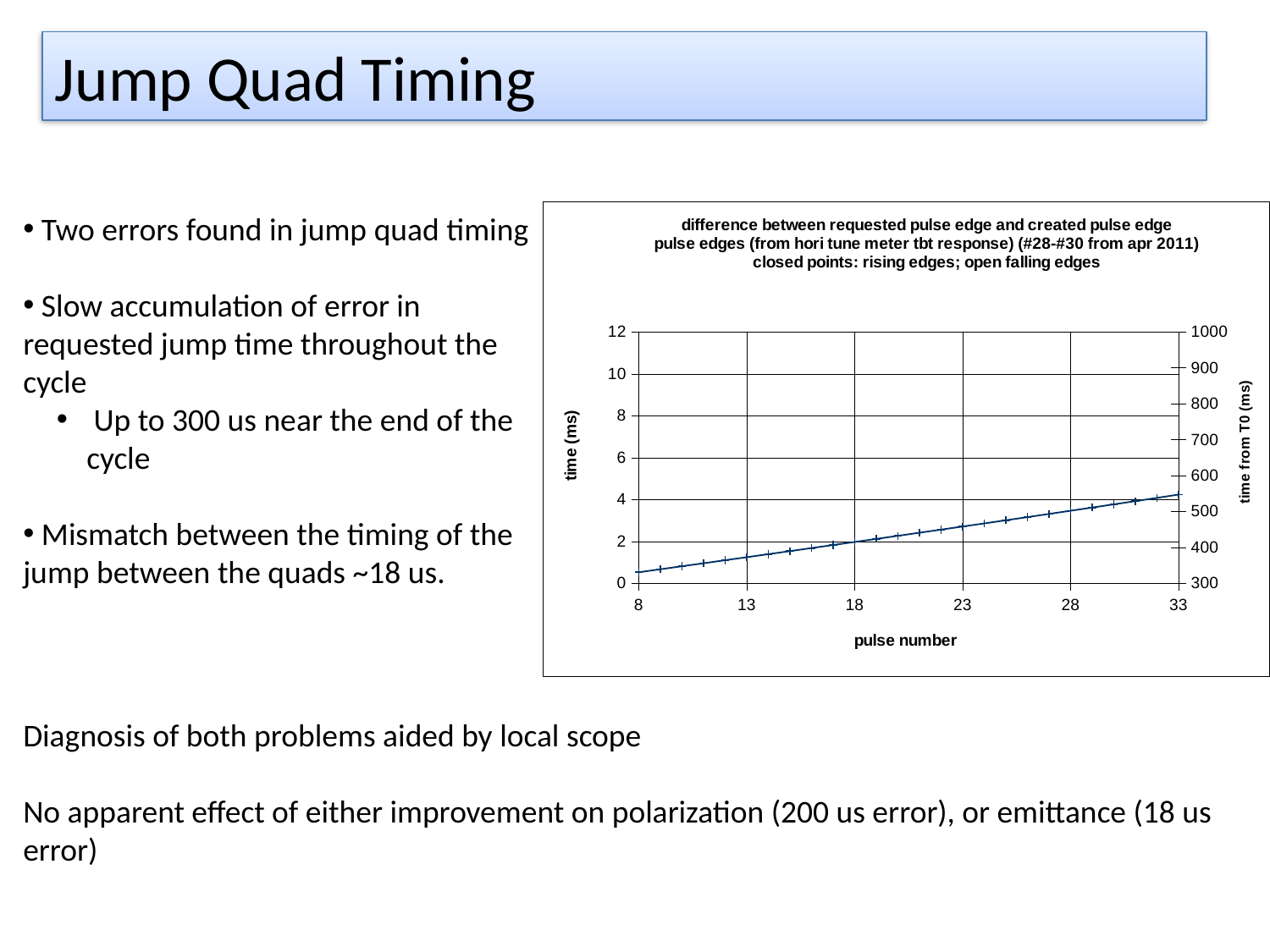
Is the value at pulse number 28 greater or less than 4 ms on the left axis? less What is the label of the right-hand y axis of the chart? time from T0 (ms) Is the value at pulse number 23 greater or less than 2 ms on the left axis? greater Is the value at pulse number 13 greater or less than 2 ms on the left axis? less Do the plotted values rise or fall as the pulse number increases from 8 to 33? rise What kind of chart is shown on the slide? line chart Which has the larger value, pulse number 13 or pulse number 28? pulse number 28 What is the label of the x axis of the chart? pulse number